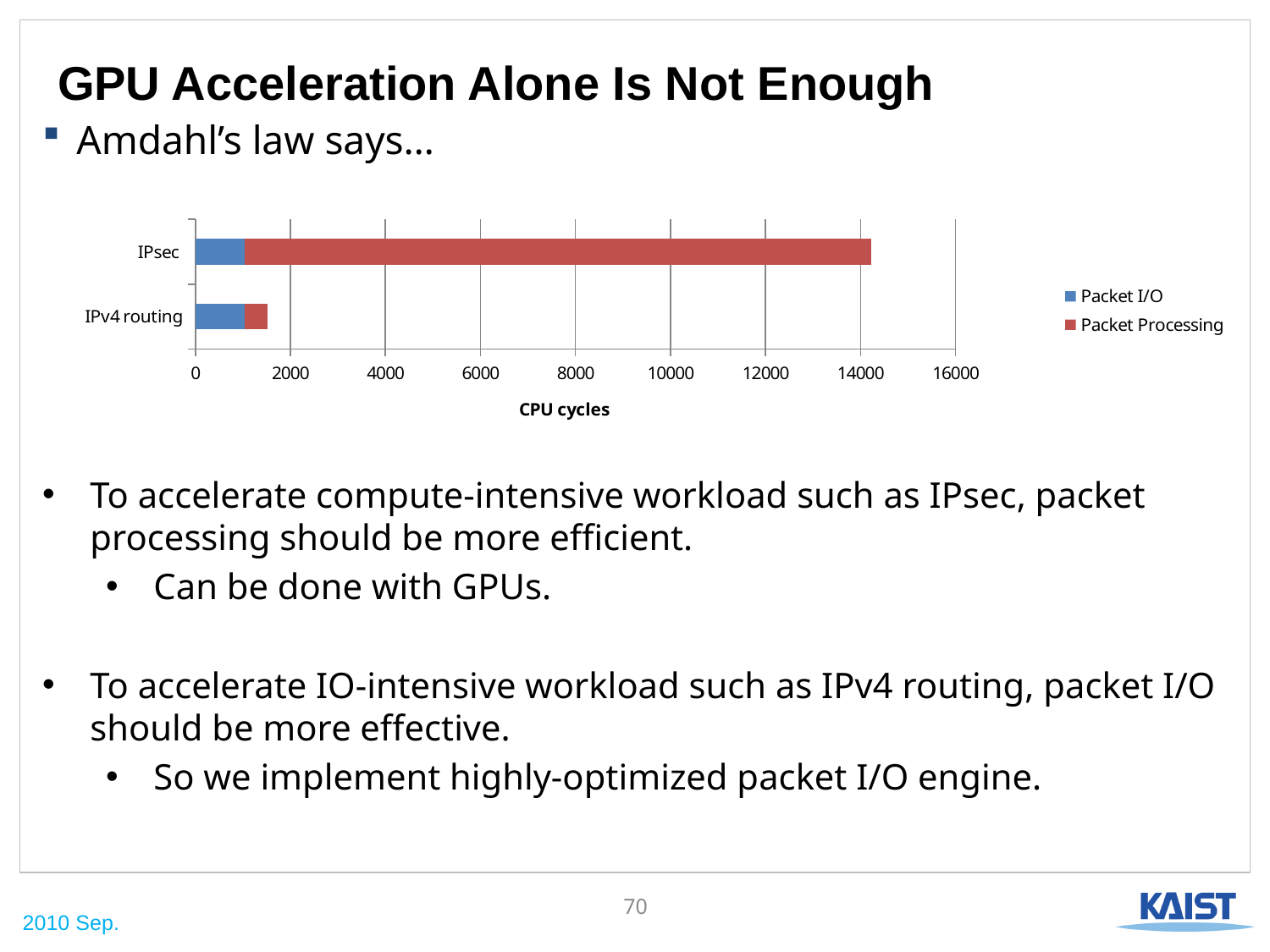
How many categories are plotted on the vertical axis of the chart? 2 What is the title of the horizontal axis of the chart? CPU cycles Is the Packet I/O value for IPsec greater or less than 2000? less What kind of chart is shown on the slide? Bar chart Is the total CPU cycles value for IPsec greater or less than 12000? greater What are the two series named in the chart's legend? Packet I/O and Packet Processing Is the total CPU cycles value for IPv4 routing greater or less than 2000? less How many series does the chart's legend list? 2 For IPsec, which series takes more CPU cycles, Packet I/O or Packet Processing? Packet Processing Which category has the longest total bar in the chart? IPsec Which category has the shortest total bar in the chart? IPv4 routing Which category uses more CPU cycles in total, IPsec or IPv4 routing? IPsec